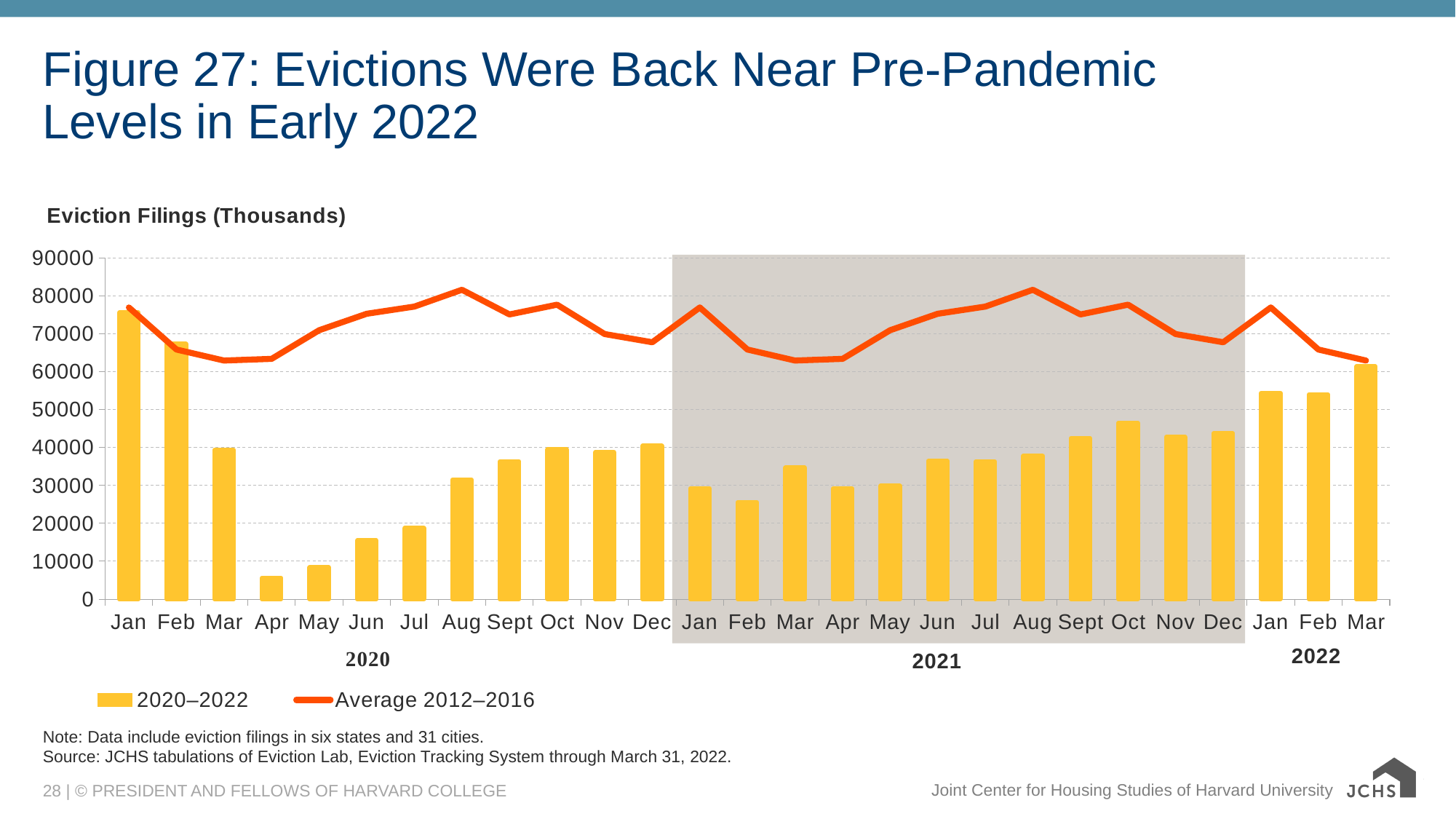
Is the value for Mar 2022 in the 2020–2022 series greater or less than 60000? greater Is the value for Oct 2021 in the 2020–2022 series greater or less than 50000? less Is the value for Apr 2020 in the 2020–2022 series greater or less than 10000? less Which month has the lowest bar in the 2020–2022 series? Apr 2020 What kind of chart is shown on the slide? A bar chart with a line overlay Do the 2020–2022 bars rise or fall from Apr 2020 to Dec 2020? rise Which is larger in the 2020–2022 series: Feb 2020 or Feb 2021? Feb 2020 Which is larger in the 2020–2022 series: Jan 2021 or Jan 2022? Jan 2022 What is the name of the line series in the legend? Average 2012–2016 Which month has the highest bar in the 2020–2022 series? Jan 2020 How many monthly bars are plotted in the 2020–2022 series? 27 How many series does the legend list? 2